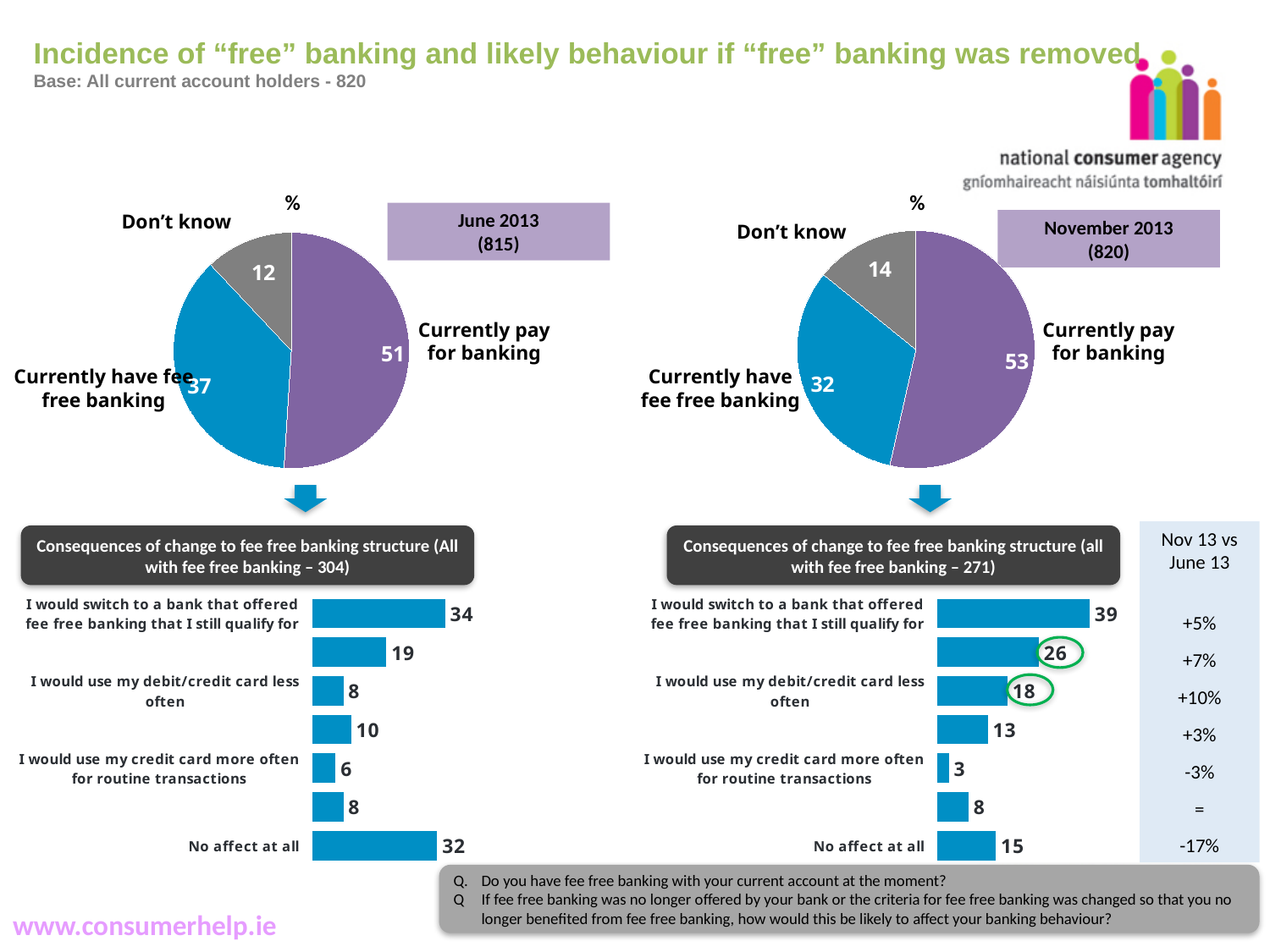
In the November 2013 pie chart, what percentage currently have fee free banking? 32 In the June 2013 pie chart, which slice is the smallest? Don't know In the November 2013 consequences bar chart, what is the value for 'I would switch to a bank that offered fee free banking that I still qualify for'? 39 How many slices does the June 2013 pie chart have? 3 What type of chart is used for the June 2013 and November 2013 data at the top of the slide? Pie chart In the June 2013 pie chart, what percentage currently pay for banking? 51 In the November 2013 pie chart, which slice is the largest? Currently pay for banking In the November 2013 pie chart, what is the value for Don't know? 14 What is the difference between the Currently have fee free banking values in the June 2013 and November 2013 pie charts? 5 In the June 2013 consequences bar chart, what is the value for 'No affect at all'? 32 In the November 2013 consequences bar chart, which labelled category has the lowest value? I would use my credit card more often for routine transactions In the June 2013 consequences bar chart, is the value for 'I would switch to a bank that offered fee free banking that I still qualify for' larger or smaller than the value for 'No affect at all'? Larger